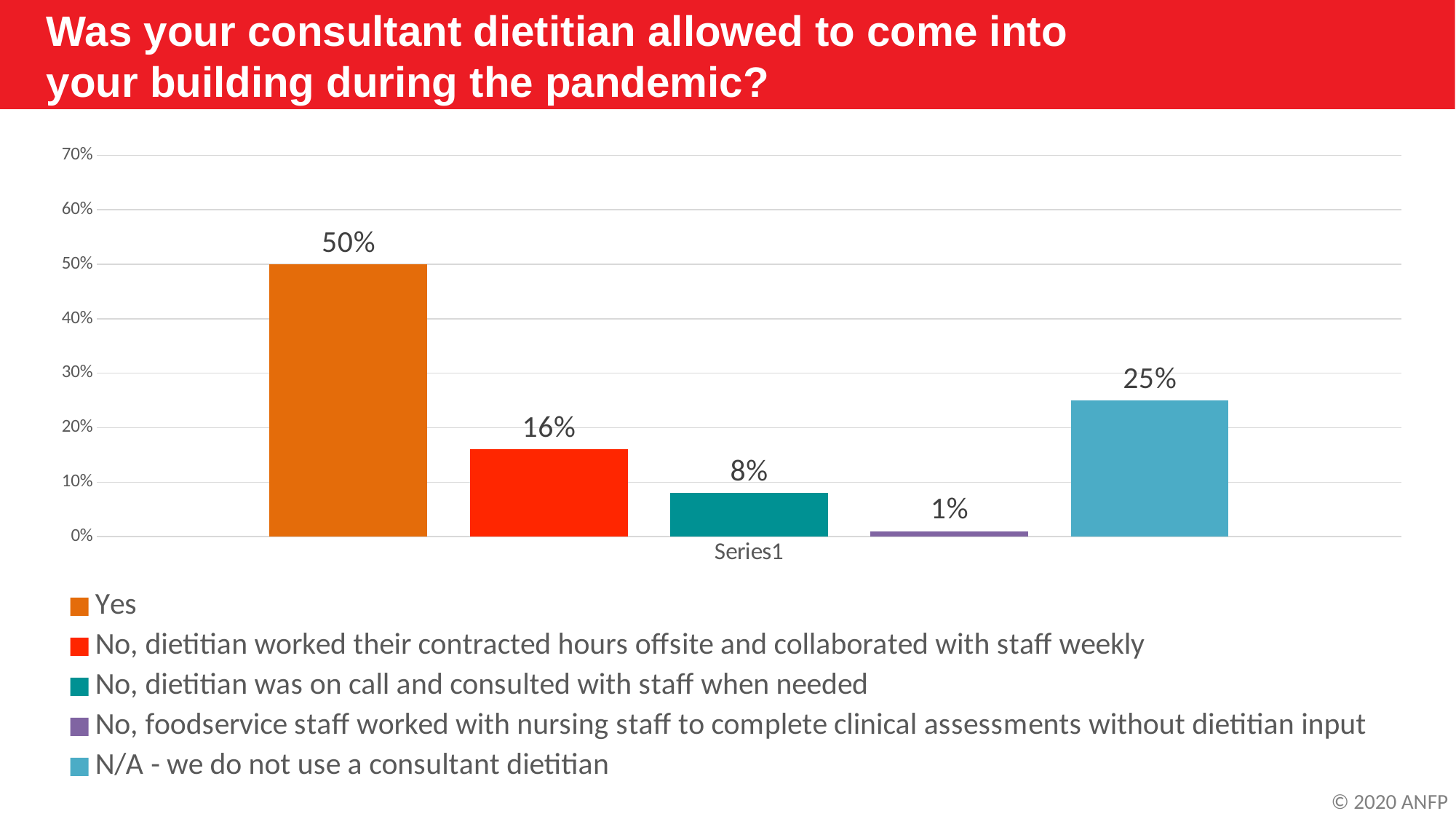
Which response has the lowest percentage? No, foodservice staff worked with nursing staff to complete clinical assessments without dietitian input What is the highest value shown on the vertical axis? 70% Which is larger: the percentage for "No, dietitian worked their contracted hours offsite and collaborated with staff weekly" or for "No, dietitian was on call and consulted with staff when needed"? No, dietitian worked their contracted hours offsite and collaborated with staff weekly How many response categories are shown in the chart? 5 What kind of chart is shown on the slide? Bar chart What colour is the bar for "Yes"? Orange What percentage of respondents said foodservice staff worked with nursing staff to complete clinical assessments without dietitian input? 1% What percentage of respondents said the dietitian was on call and consulted with staff when needed? 8% What percentage of respondents answered "Yes"? 50% What percentage of respondents answered "N/A - we do not use a consultant dietitian"? 25% Which response has the highest percentage? Yes What is the difference in percentage points between "Yes" and "N/A - we do not use a consultant dietitian"? 25